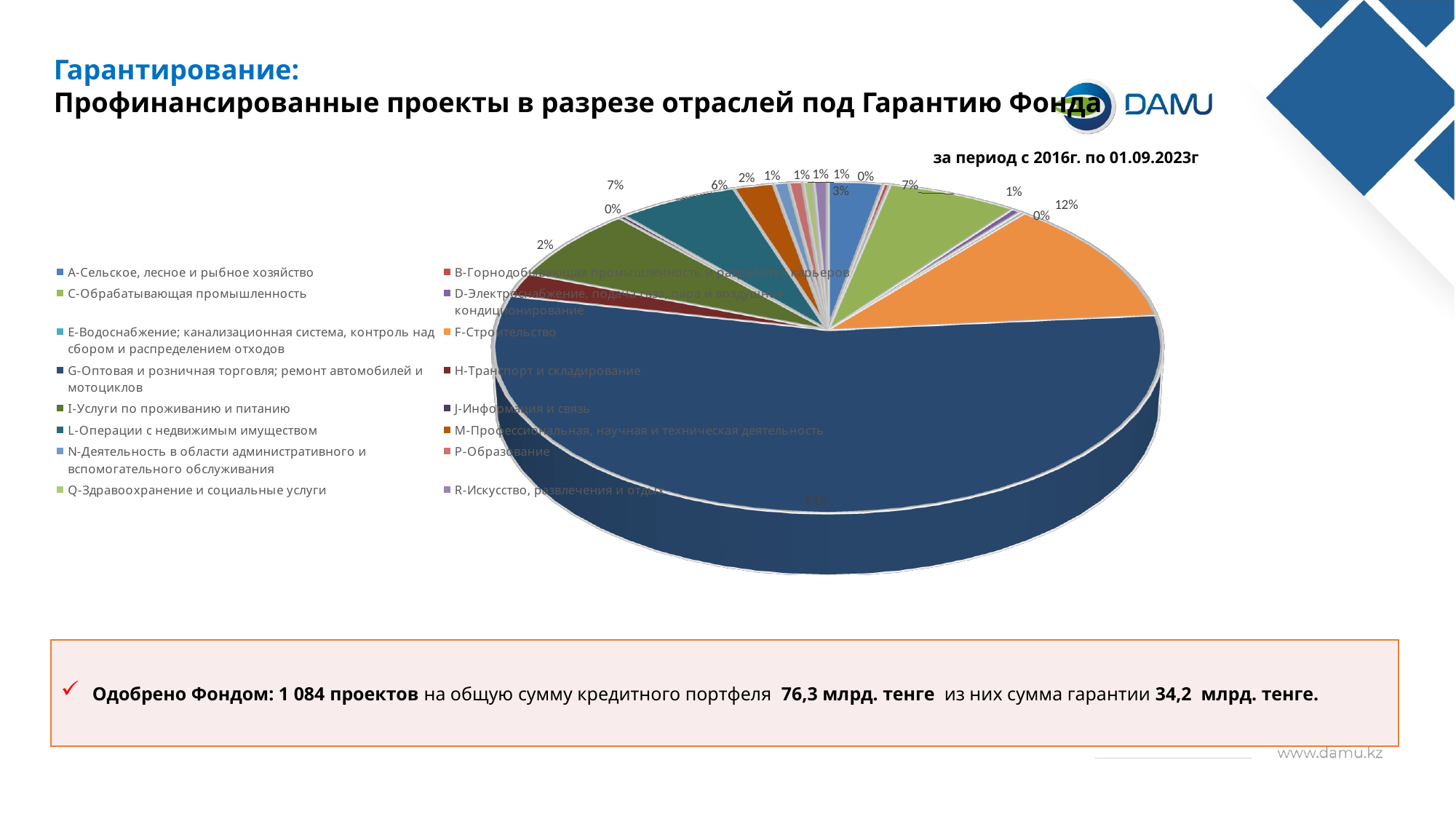
Is the share for G-Оптовая и розничная торговля greater or less than 50%? greater What period does the chart cover, according to the text above it? за период с 2016г. по 01.09.2023г What share of the pie does F-Строительство have? 12% What share of the pie does A-Сельское, лесное и рыбное хозяйство have? 3% Which category has the largest share of the pie? G-Оптовая и розничная торговля; ремонт автомобилей и мотоциклов What share of the pie does G-Оптовая и розничная торговля; ремонт автомобилей и мотоциклов have? 54% What is the difference between the share for G-Оптовая и розничная торговля (54%) and the share for F-Строительство (12%)? 42% What is the title of the slide? Гарантирование: Профинансированные проекты в разрезе отраслей под Гарантию Фонда What kind of chart is shown on the slide? pie chart How many categories does the legend list? 16 Which is larger: the share for G-Оптовая и розничная торговля or the share for F-Строительство? G-Оптовая и розничная торговля